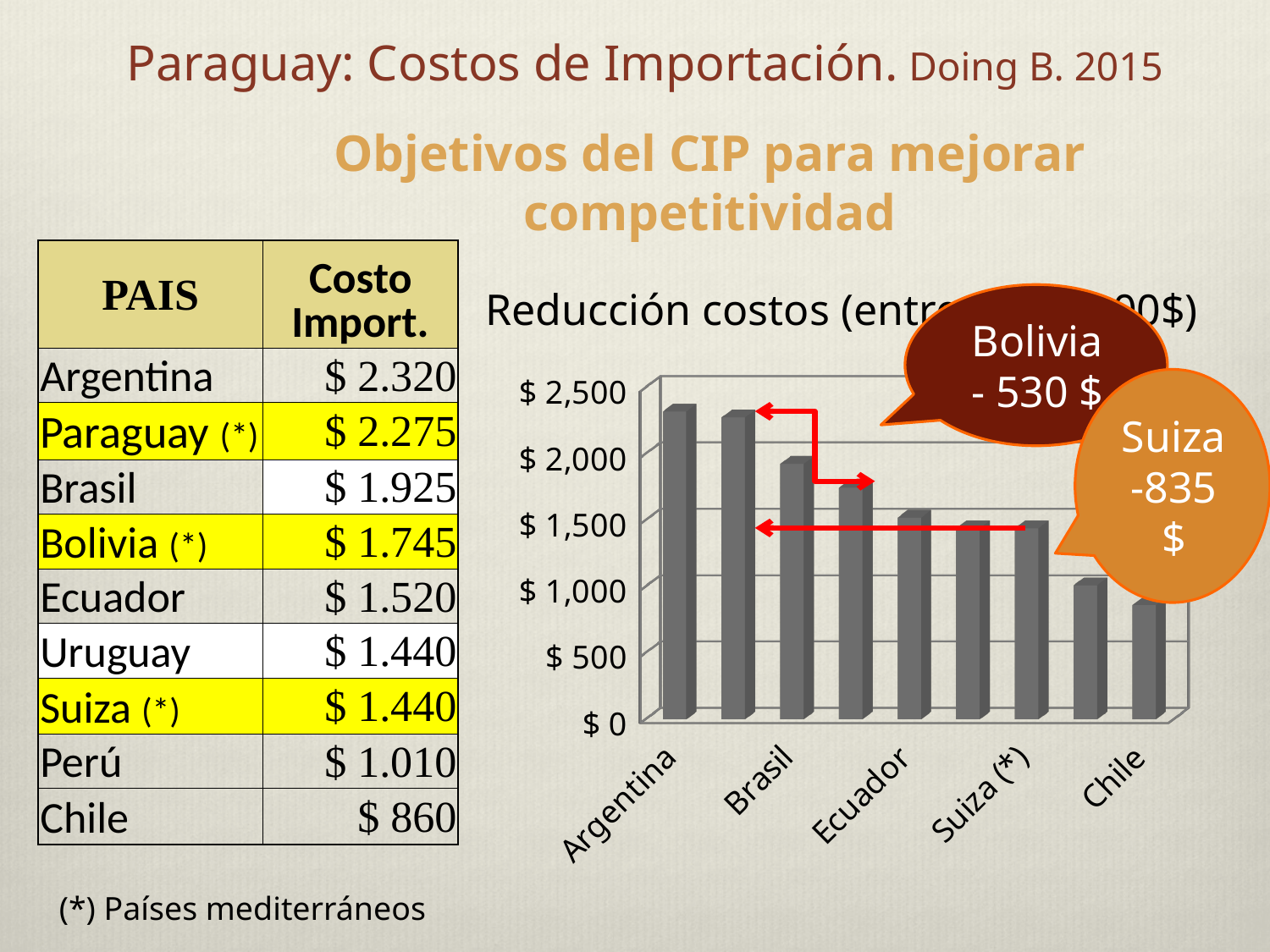
Is the value for Argentina in the chart greater or less than $ 2,000? greater Is the value for Chile in the chart greater or less than $ 1,000? less How many bars does the chart contain? 9 Which is larger in the chart, the bar for Brasil or the bar for Ecuador? Brasil What reduction amount does the callout for Bolivia on the chart show? - 530 $ Is the value for Chile in the chart greater or less than $ 500? greater What reduction amount does the callout for Suiza on the chart show? -835 $ Which is larger in the chart, the bar for Argentina or the bar for Chile? Argentina Which country has the lowest bar in the chart? Chile Do the bar values rise or fall from left to right along the x axis? fall What kind of chart is shown on the slide? bar chart